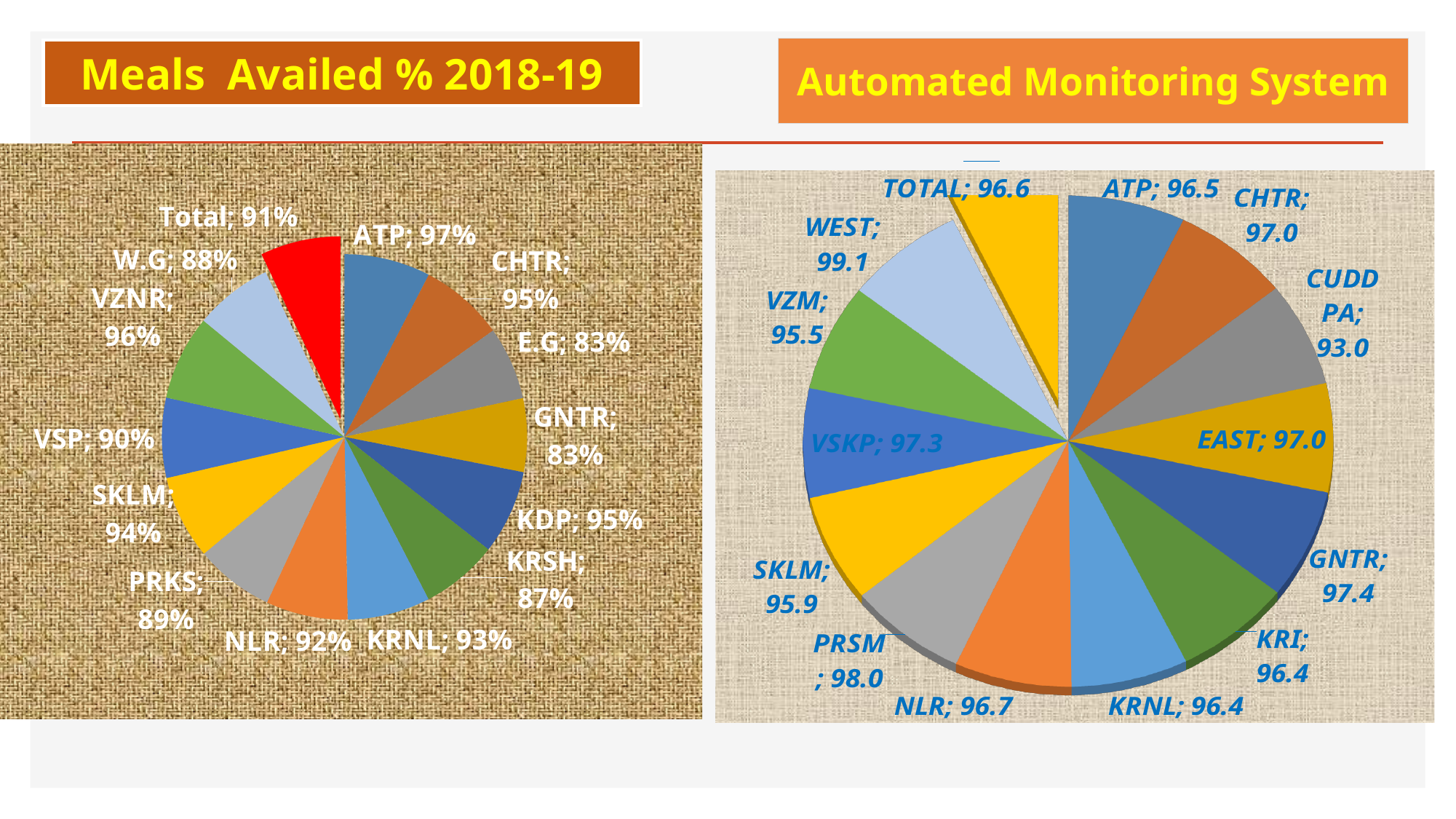
In the Meals Availed % 2018-19 pie chart, what is the value for ATP? 97% In the Automated Monitoring System pie chart, what is the difference between the values for WEST and VZM? 3.6 In the Automated Monitoring System pie chart, which district has the lowest value? CUDDPA In the Meals Availed % 2018-19 pie chart, which is larger, the value for SKLM or the value for VSP? SKLM How many slices does the Meals Availed % 2018-19 pie chart have? 14 In the Automated Monitoring System pie chart, what is the value for CUDDPA? 93.0 In the Meals Availed % 2018-19 pie chart, what is the difference between the values for VZNR and W.G? 8% In the Meals Availed % 2018-19 pie chart, which district has the highest value? ATP In the Automated Monitoring System pie chart, what is the value for PRSM? 98.0 What type of chart is used on the left side of the slide for Meals Availed % 2018-19? Pie chart In the Meals Availed % 2018-19 pie chart, what is the value for KRSH? 87% In the Automated Monitoring System pie chart, which district has the highest value? WEST